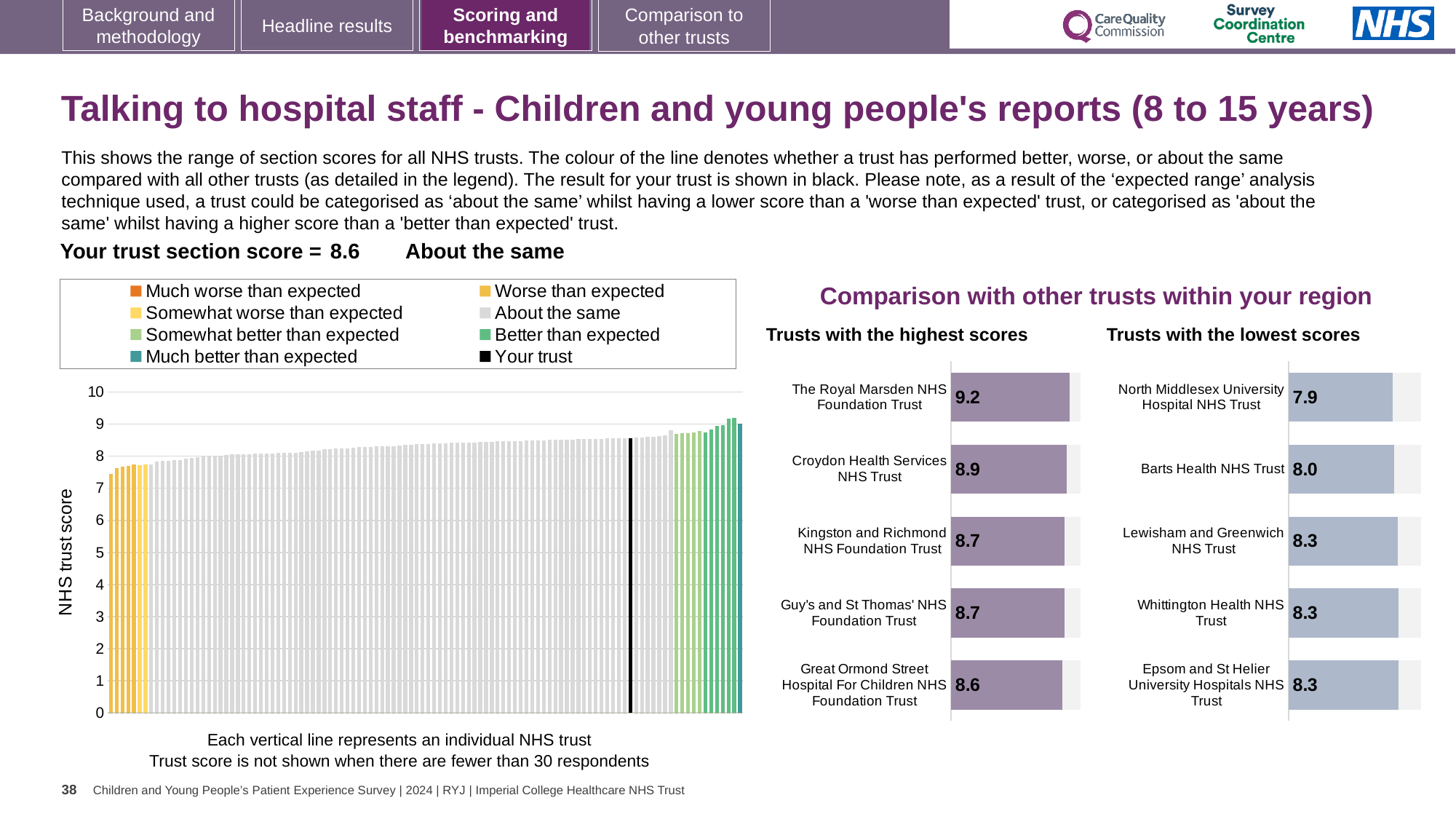
What kind of chart is the large chart on the left showing the scores of all NHS trusts? Bar chart In the 'Trusts with the lowest scores' chart, which trust has the lowest score? North Middlesex University Hospital NHS Trust In the 'Trusts with the highest scores' chart, which has the higher score: Croydon Health Services NHS Trust or Great Ormond Street Hospital For Children NHS Foundation Trust? Croydon Health Services NHS Trust In the large chart on the left showing all NHS trusts, is the value for the black 'Your trust' bar greater or less than 8? greater In the 'Trusts with the lowest scores' chart, what is the difference between the scores of Lewisham and Greenwich NHS Trust and North Middlesex University Hospital NHS Trust? 0.4 How many trusts are listed in the 'Trusts with the lowest scores' chart? 5 How many entries does the legend of the large chart on the left list? 8 In the 'Trusts with the highest scores' chart, what is the score for Great Ormond Street Hospital For Children NHS Foundation Trust? 8.6 In the 'Trusts with the highest scores' chart, what is the difference between the scores of The Royal Marsden NHS Foundation Trust and Great Ormond Street Hospital For Children NHS Foundation Trust? 0.6 In the 'Trusts with the highest scores' chart, what is the score for The Royal Marsden NHS Foundation Trust? 9.2 In the 'Trusts with the highest scores' chart, which trust has the highest score? The Royal Marsden NHS Foundation Trust In the 'Trusts with the lowest scores' chart, what is the score for Barts Health NHS Trust? 8.0